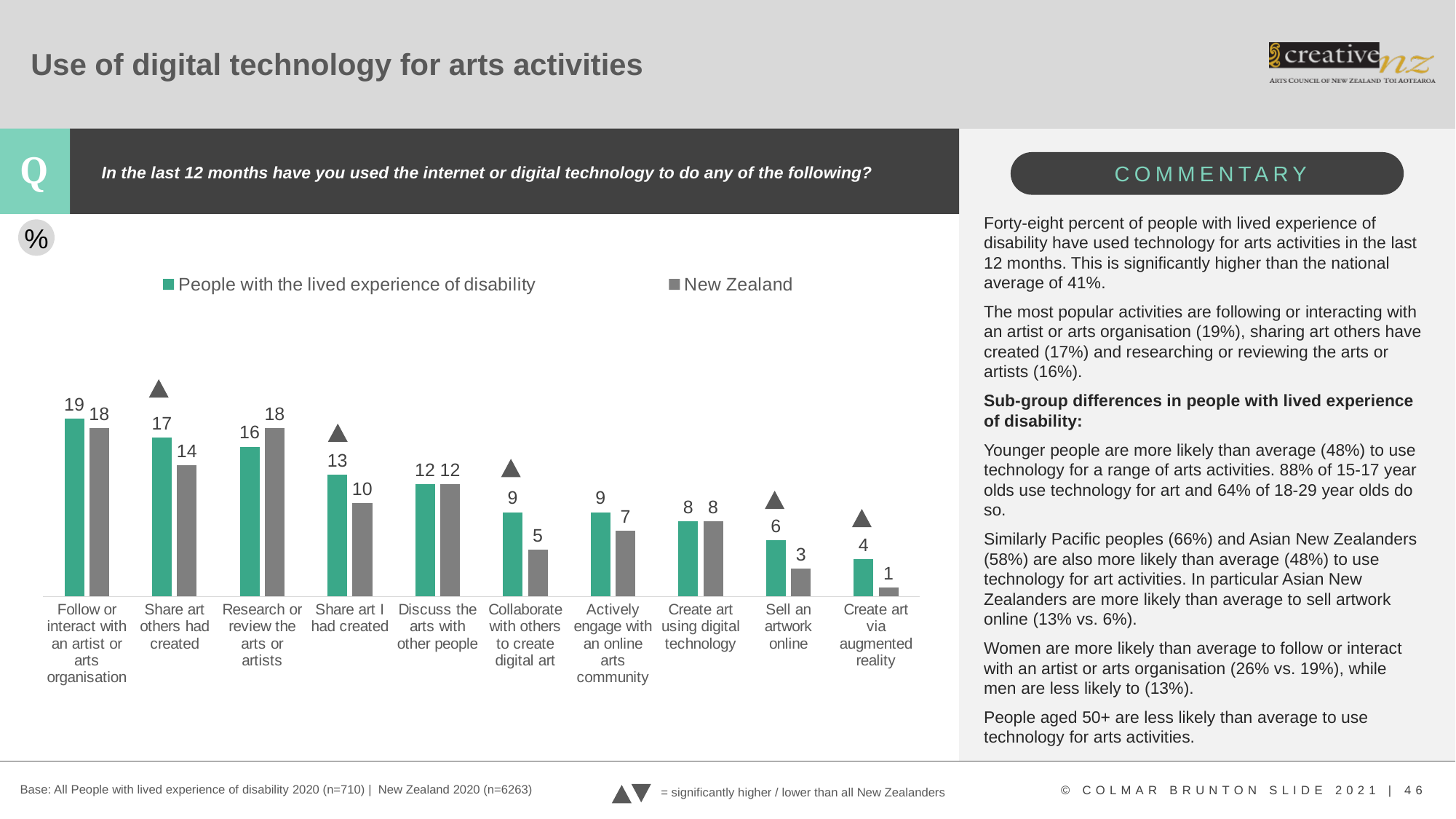
What is the difference between the 'People with the lived experience of disability' and 'New Zealand' values for 'Collaborate with others to create digital art'? 4 For 'Research or review the arts or artists', which series has the larger value: 'People with the lived experience of disability' or 'New Zealand'? New Zealand What kind of chart is shown on the slide? Bar chart Which series is shown in green in the chart legend? People with the lived experience of disability How many categories are shown on the x axis of the chart? 10 What is the value for 'People with the lived experience of disability' for 'Sell an artwork online'? 6 Which category has the highest value for 'People with the lived experience of disability'? Follow or interact with an artist or arts organisation How many series does the chart legend list? 2 What is the 'New Zealand' value for 'Share art others had created'? 14 Which category has the lowest 'New Zealand' value? Create art via augmented reality What is the 'New Zealand' value for 'Research or review the arts or artists'? 18 What is the value for 'People with the lived experience of disability' for 'Follow or interact with an artist or arts organisation'? 19